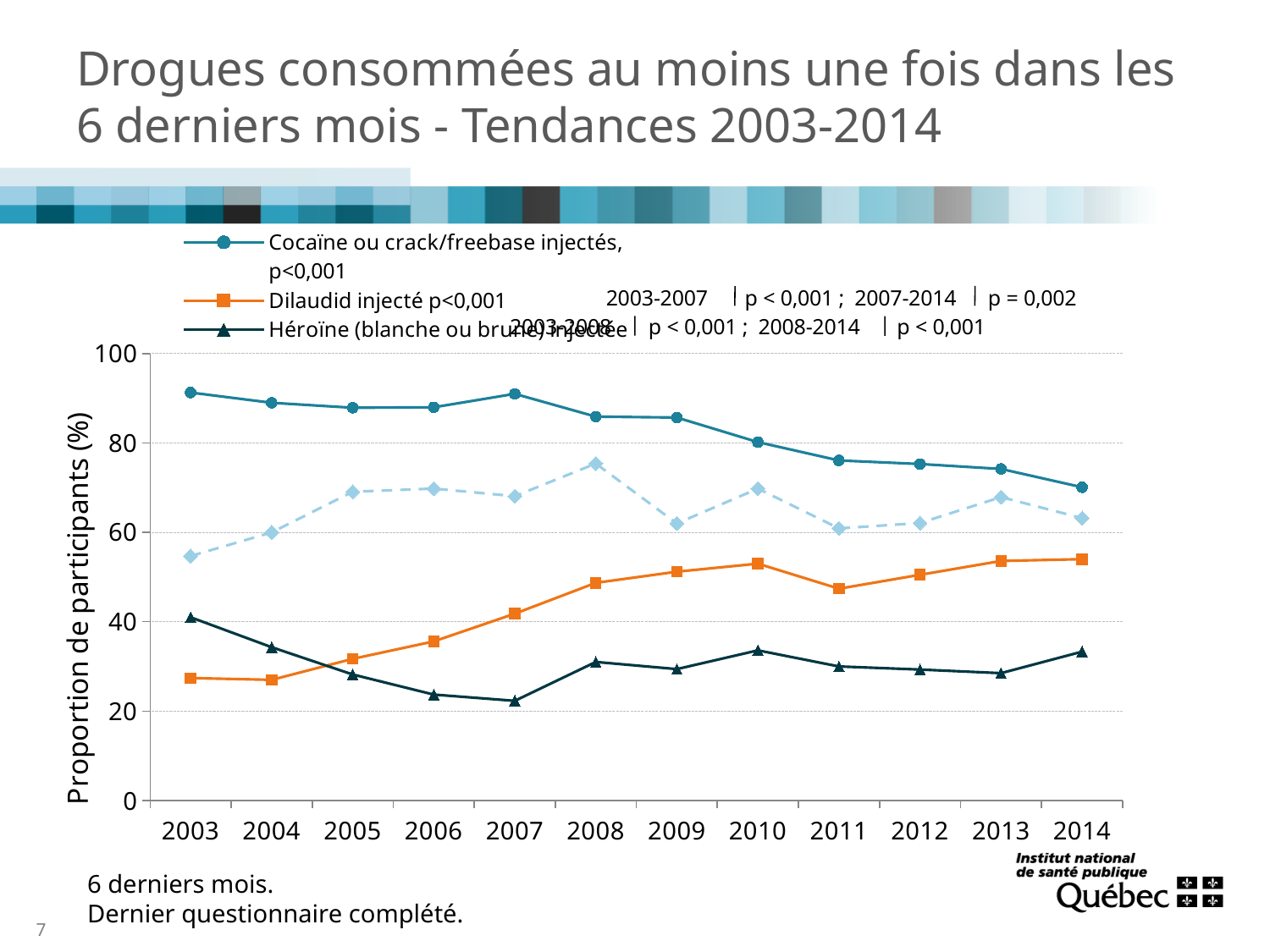
How many years are plotted along the x axis? 12 Is the value for 'Héroïne (blanche ou brune) injectée' in 2007 greater or less than 40? less What kind of chart is shown on the slide? line chart Does the value for 'Dilaudid injecté' rise or fall from 2003 to 2014? rise Is the value for 'Cocaïne ou crack/freebase injectés' in 2003 greater or less than 80? greater Does the value for 'Cocaïne ou crack/freebase injectés' rise or fall from 2003 to 2014? fall In which year is the value for 'Cocaïne ou crack/freebase injectés' lowest? 2014 In 2014, which is larger: 'Cocaïne ou crack/freebase injectés' or 'Dilaudid injecté'? Cocaïne ou crack/freebase injectés How many series does the legend list? 3 Is the value for 'Dilaudid injecté' in 2003 greater or less than 40? less In 2003, which is larger: 'Dilaudid injecté' or 'Héroïne (blanche ou brune) injectée'? Héroïne (blanche ou brune) injectée What is the title of the y axis? Proportion de participants (%)